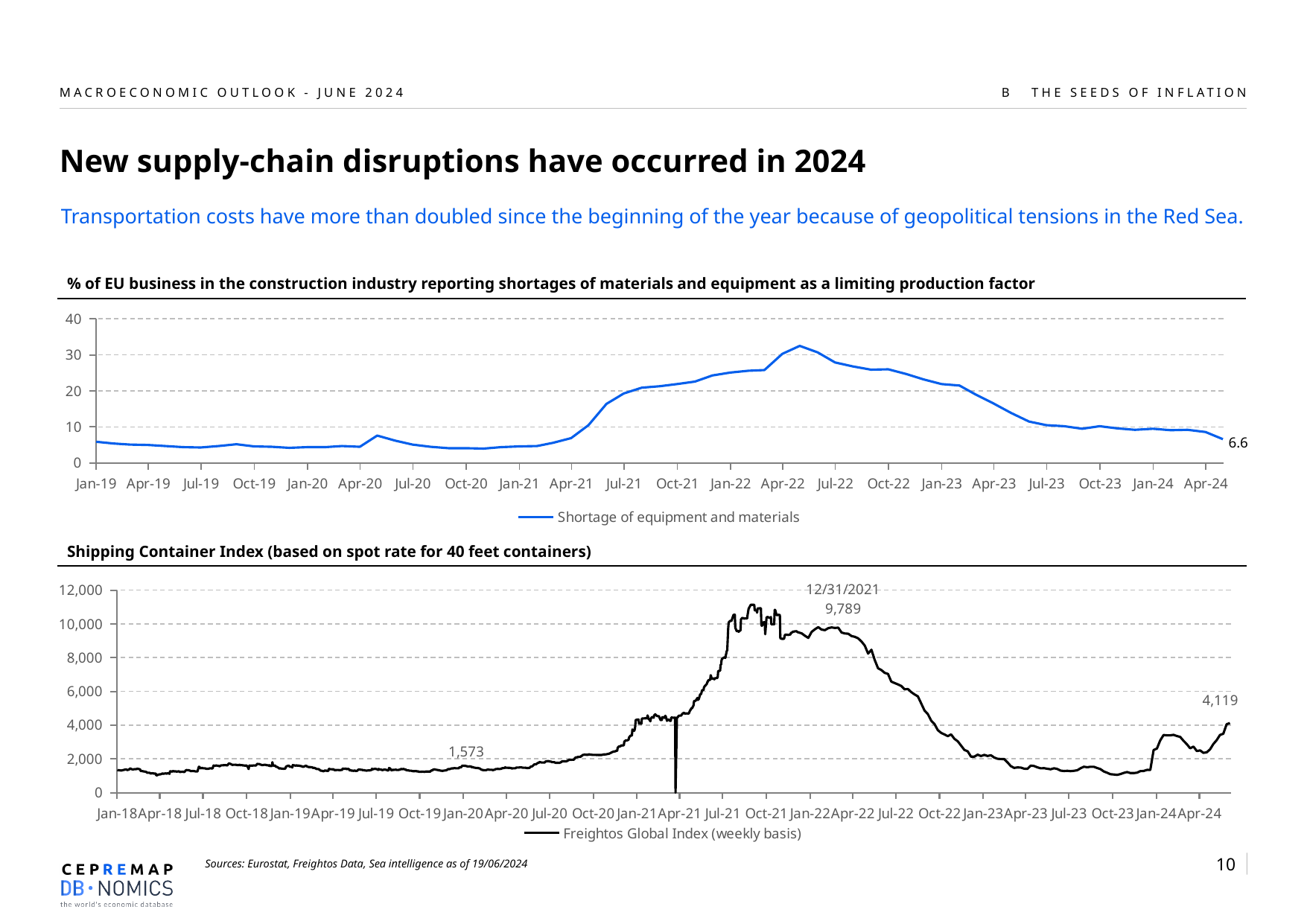
What kind of chart is the top chart, '% of EU business in the construction industry reporting shortages of materials and equipment as a limiting production factor'? Line chart In the top chart on shortages of materials and equipment, do the values rise or fall between Apr-22 and Apr-24? fall In the bottom chart, 'Shipping Container Index', what is the difference between the value labelled at 12/31/2021 (9,789) and the latest labelled value (4,119)? 5,670 In the top chart on shortages of materials and equipment, is the value at Jan-19 greater or less than 10? less In the bottom chart, 'Shipping Container Index', what is the name of the series shown in the legend? Freightos Global Index (weekly basis) In the bottom chart, 'Shipping Container Index', what is the difference between the latest labelled value (4,119) and the earlier labelled value of 1,573? 2,546 In the top chart on shortages of materials and equipment, how many series does the legend list? 1 In the bottom chart, 'Shipping Container Index', what value is labelled at 12/31/2021? 9,789 In the bottom chart, 'Shipping Container Index', is the value at Jan-18 greater or less than 2,000? less In the top chart on shortages of materials and equipment, is the peak value reached around Apr-22 greater or less than 30? greater In the top chart on shortages of materials and equipment, what is the value shown at the end of the series (Apr-24)? 6.6 In the bottom chart, 'Shipping Container Index', what is the latest value labelled at the end of the series? 4,119